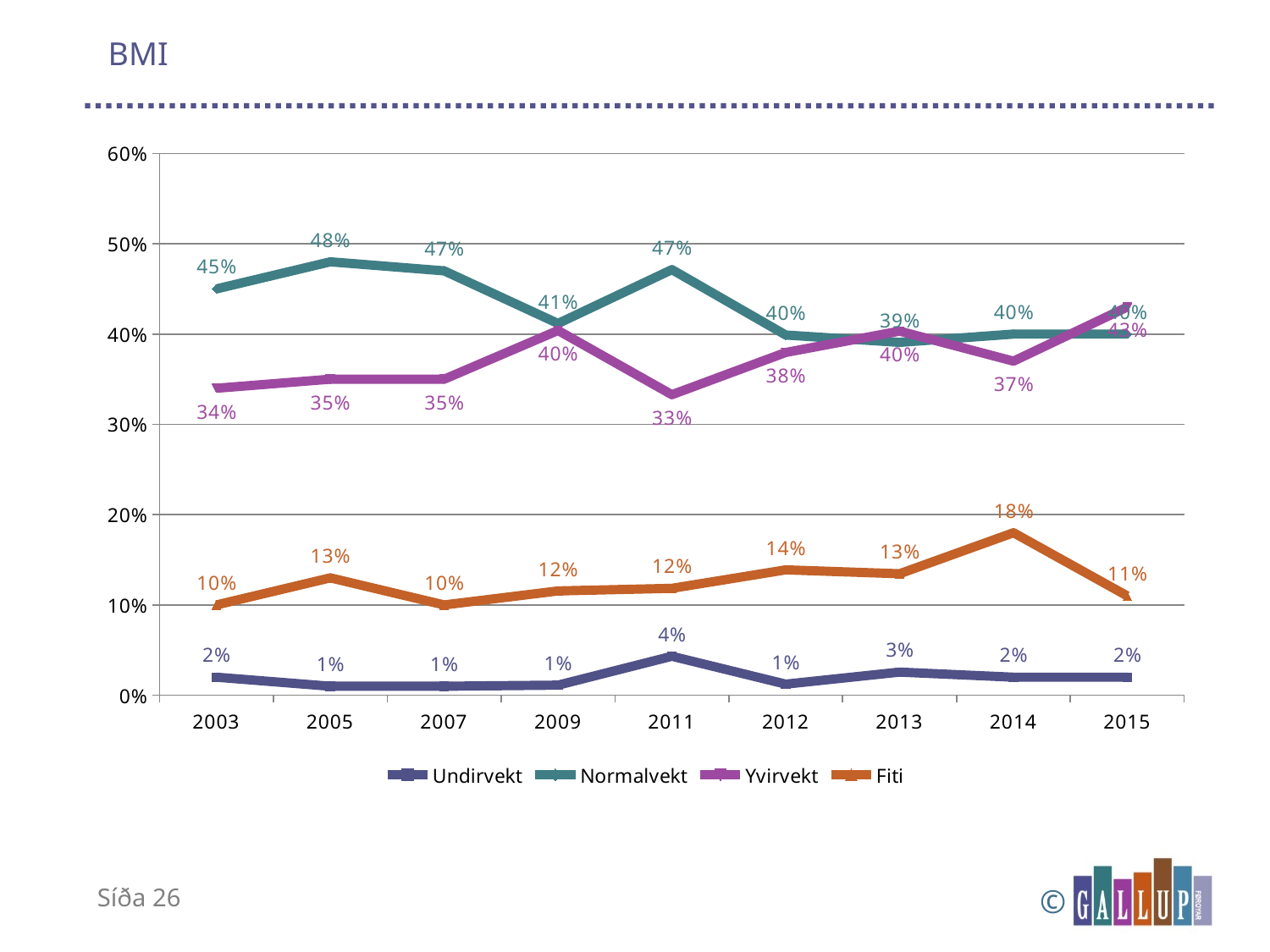
How many series does the legend list? 4 What type of chart is shown on the slide? Line chart In 2011, which is larger: Normalvekt or Yvirvekt? Normalvekt Which series is shown in orange? Fiti In which year is Undirvekt at its highest? 2011 What is the value for Undirvekt in 2011? 4% In which year is Fiti at its highest? 2014 What is the value for Fiti in 2014? 18% How many years are shown on the x axis? 9 In which year is Yvirvekt at its lowest? 2011 What is the value for Normalvekt in 2005? 48% What is the difference between Normalvekt in 2005 and Normalvekt in 2009? 7 percentage points